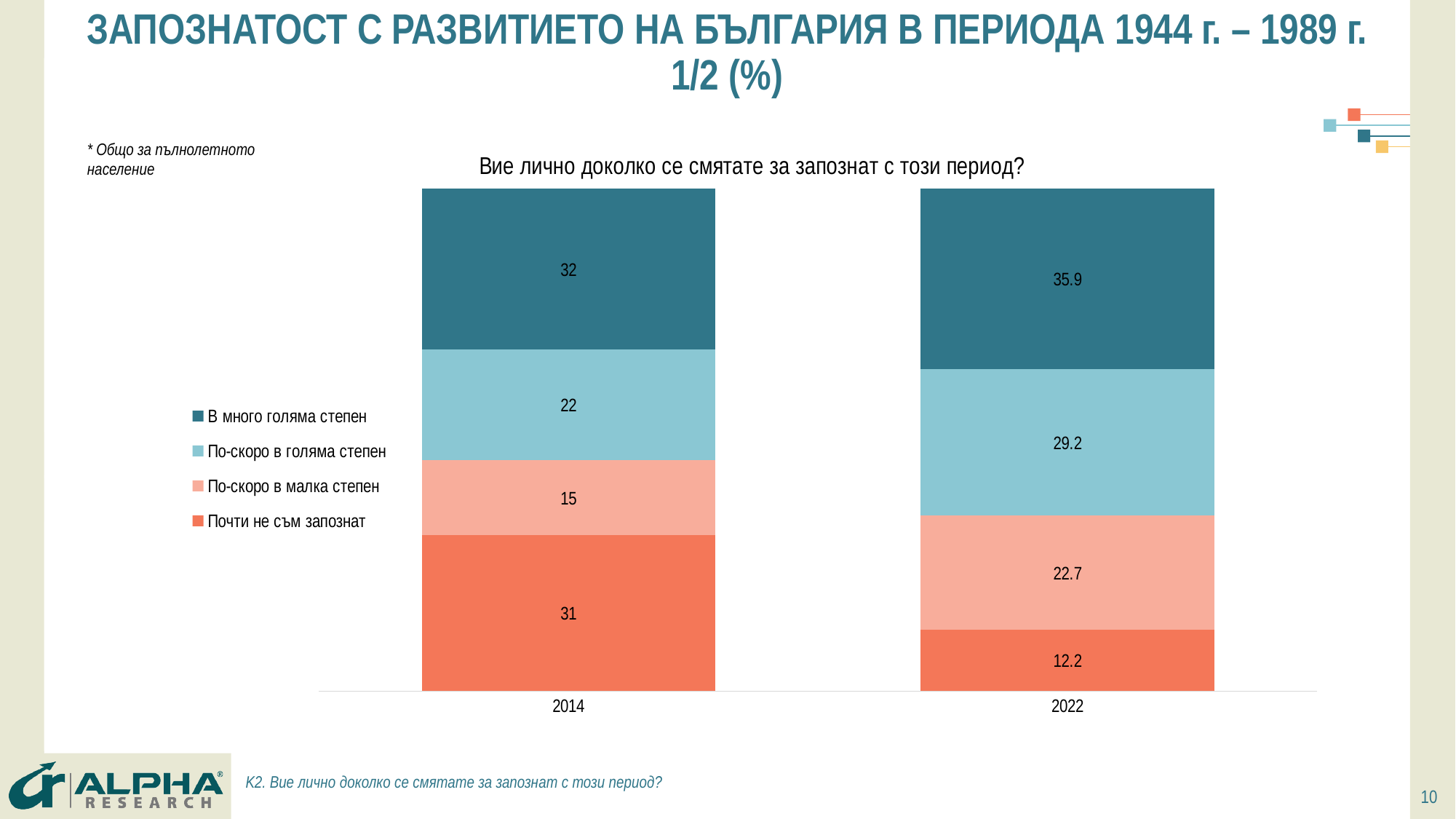
What is the value for "По-скоро в малка степен" in 2022? 22.7 What is the value for "По-скоро в голяма степен" in 2014? 22 What is the value for "Почти не съм запознат" in 2014? 31 What is the difference between the "Почти не съм запознат" values for 2014 and 2022? 18.8 Which series has the highest value in 2022? В много голяма степен How many series does the legend list? 4 Which series has the lowest value in 2014? По-скоро в малка степен How many categories are shown on the x axis? 2 Which is larger: "По-скоро в голяма степен" in 2014 or in 2022? 2022 What type of chart is shown on the slide? stacked bar chart What is the value for "В много голяма степен" in 2022? 35.9 What is the total of the stacked bar for 2014? 100